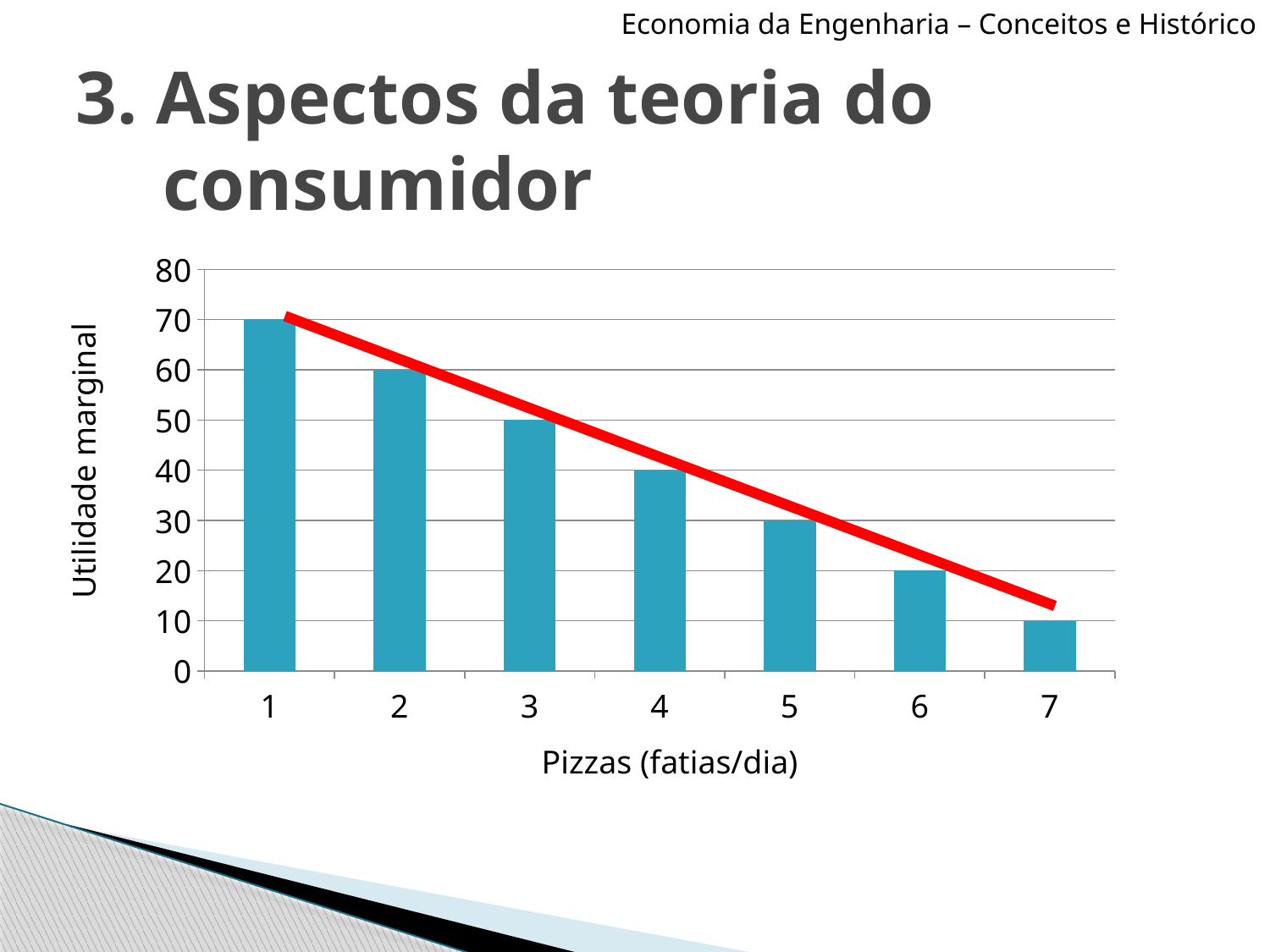
Which has a larger marginal utility: 3 slices per day or 6 slices per day? 3 slices per day What kind of chart is shown on the slide? bar chart What is the marginal utility (Utilidade marginal) for 1 pizza slice per day? 70 How many categories (numbers of pizza slices) are plotted on the x axis? 7 Which number of pizza slices per day has the lowest marginal utility? 7 What is the difference in marginal utility between 2 slices and 5 slices per day? 30 What is the marginal utility for 4 pizza slices per day? 40 Do the marginal utility values rise or fall as the number of pizza slices per day increases? fall Is the marginal utility for 5 slices per day greater or less than 40? less What is the label of the x axis of the chart? Pizzas (fatias/dia) Which number of pizza slices per day has the highest marginal utility? 1 What is the marginal utility for 7 pizza slices per day? 10